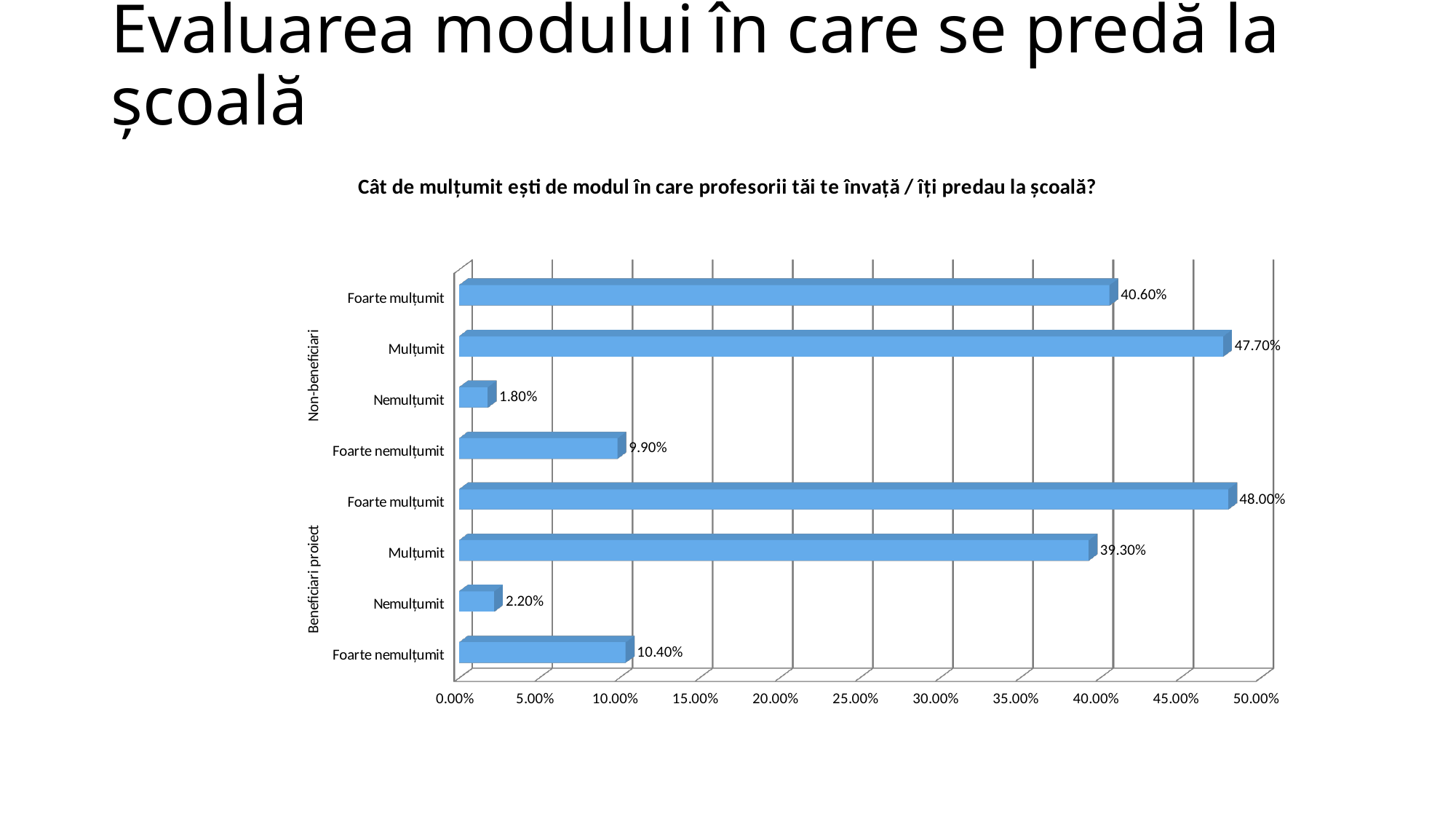
What kind of chart is shown on the slide? Bar chart What is the difference between "Mulțumit" for Non-beneficiari and "Mulțumit" for Beneficiari proiect? 8.40% What is the value for "Foarte nemulțumit" in the Beneficiari proiect group? 10.40% What is the value for "Nemulțumit" in the Non-beneficiari group? 1.80% What is the title of the chart? Cât de mulțumit ești de modul în care profesorii tăi te învață / îți predau la școală? What is the value for "Foarte mulțumit" in the Non-beneficiari group? 40.60% Which is larger: "Foarte mulțumit" for Non-beneficiari or "Foarte mulțumit" for Beneficiari proiect? Foarte mulțumit for Beneficiari proiect Is the value for "Foarte nemulțumit" in the Non-beneficiari group greater or less than 10.00%? less Which category has the highest value on the chart? Foarte mulțumit (Beneficiari proiect) What is the value for "Mulțumit" in the Beneficiari proiect group? 39.30% How many bars are plotted on the chart? 8 Which category has the lowest value on the chart? Nemulțumit (Non-beneficiari)